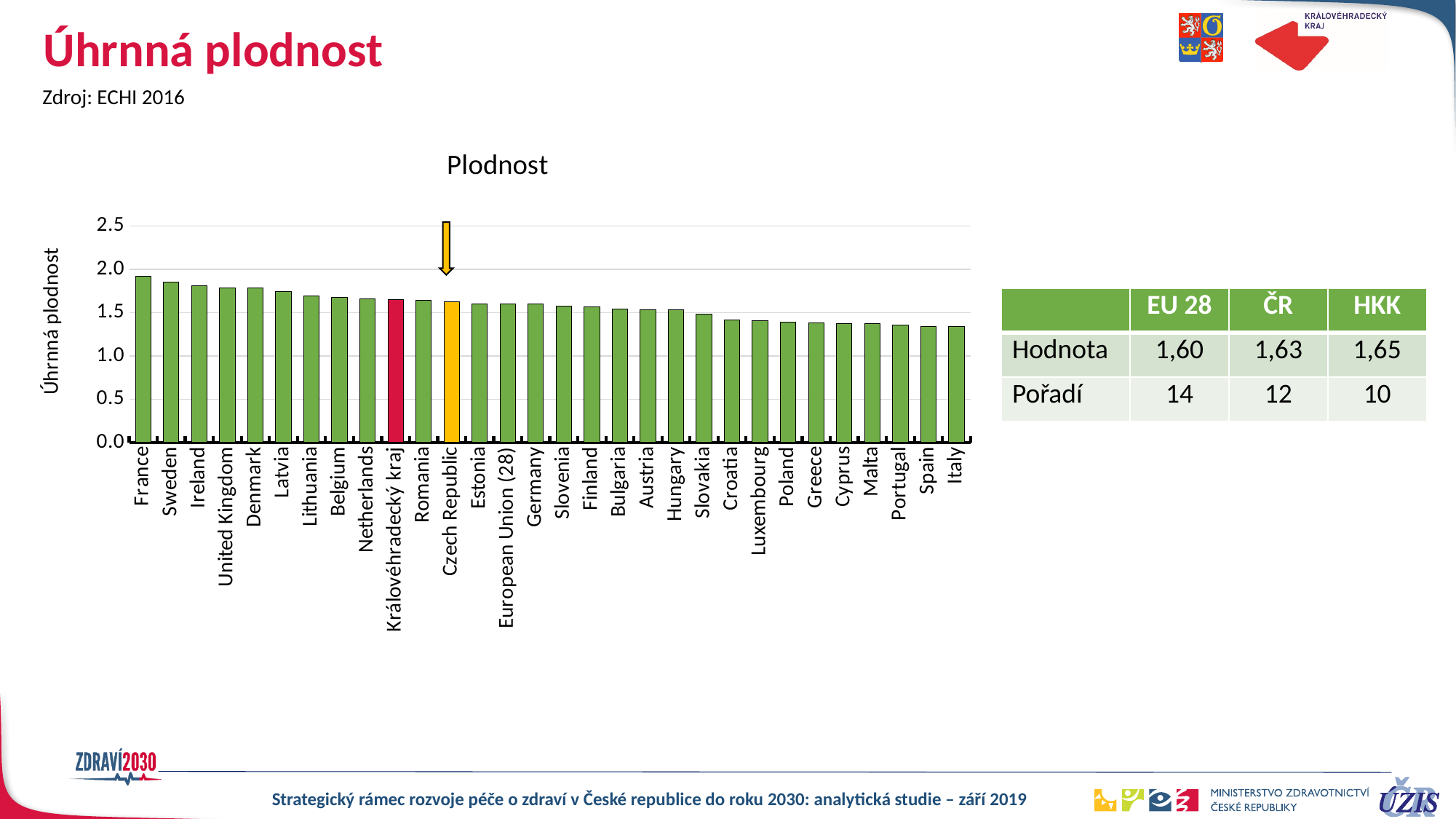
Do the bar values rise or fall from left to right along the x axis? fall How many bars (categories) are plotted in the chart? 30 What kind of chart is shown on the slide? bar chart Which has a larger value, Sweden or Spain? Sweden What is the title of the chart? Plodnost According to the table on the slide, what is the value (Hodnota) for ČR? 1,63 Is the value for Poland greater or less than 1.5? less Which category has the highest value in the chart? France Is the value for France greater or less than 1.5? greater What is the difference between the HKK value and the ČR value shown in the table? 0,02 According to the table on the slide, what is the value (Hodnota) for HKK? 1,65 According to the table on the slide, what is the value (Hodnota) for EU 28? 1,60